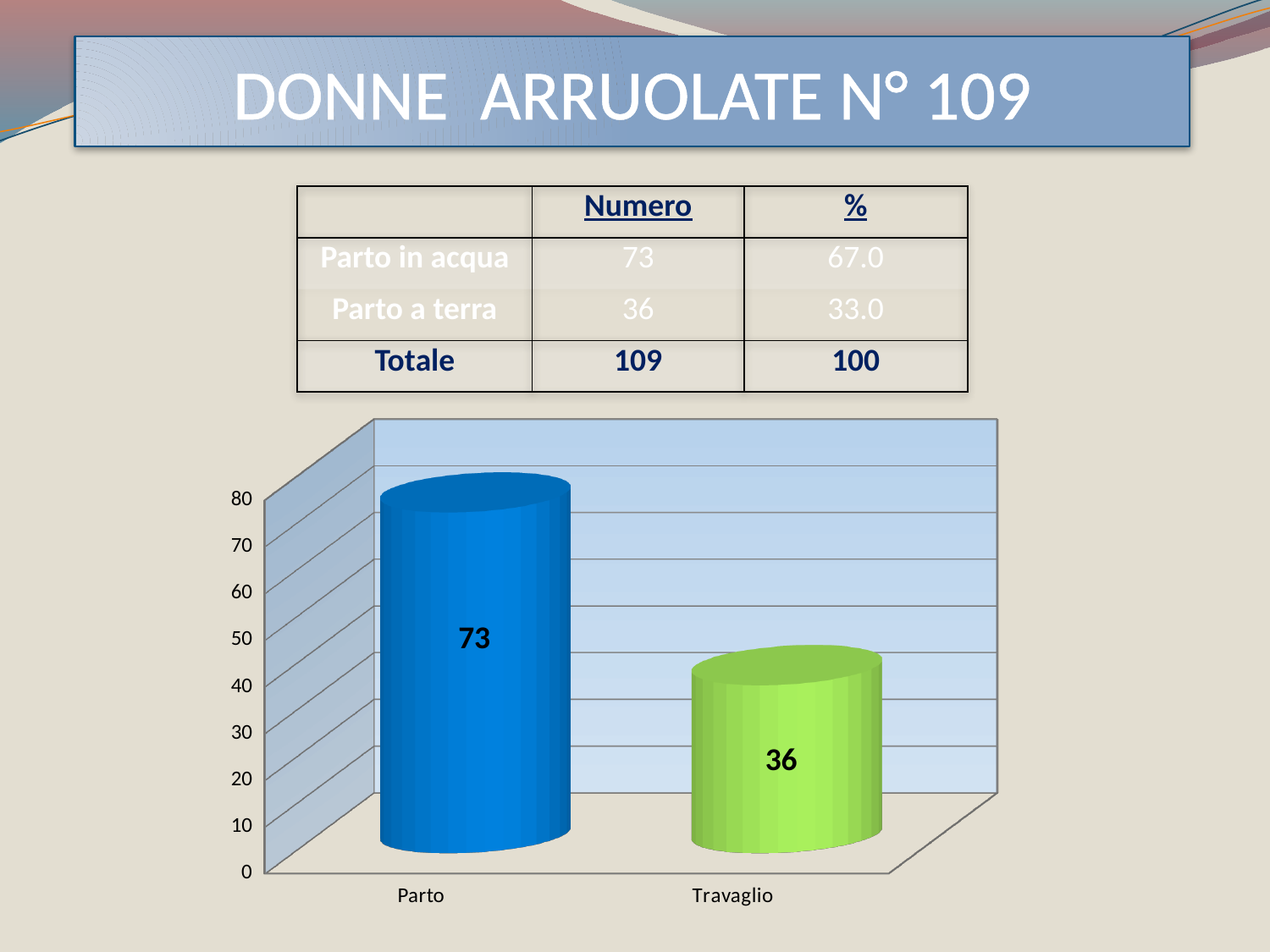
What kind of chart is shown on the slide? bar chart Do the values rise or fall from Parto to Travaglio? fall What is the value for Travaglio? 36 How many categories are shown on the x axis of the chart? 2 What colour is the bar for Travaglio? green Is the value for Parto greater or less than 70? greater Which category has the highest value? Parto What is the value for Parto? 73 What is the difference between the values for Parto and Travaglio? 37 Which is larger, the value for Parto or the value for Travaglio? Parto Is the value for Travaglio greater or less than 40? less Which category has the lowest value? Travaglio